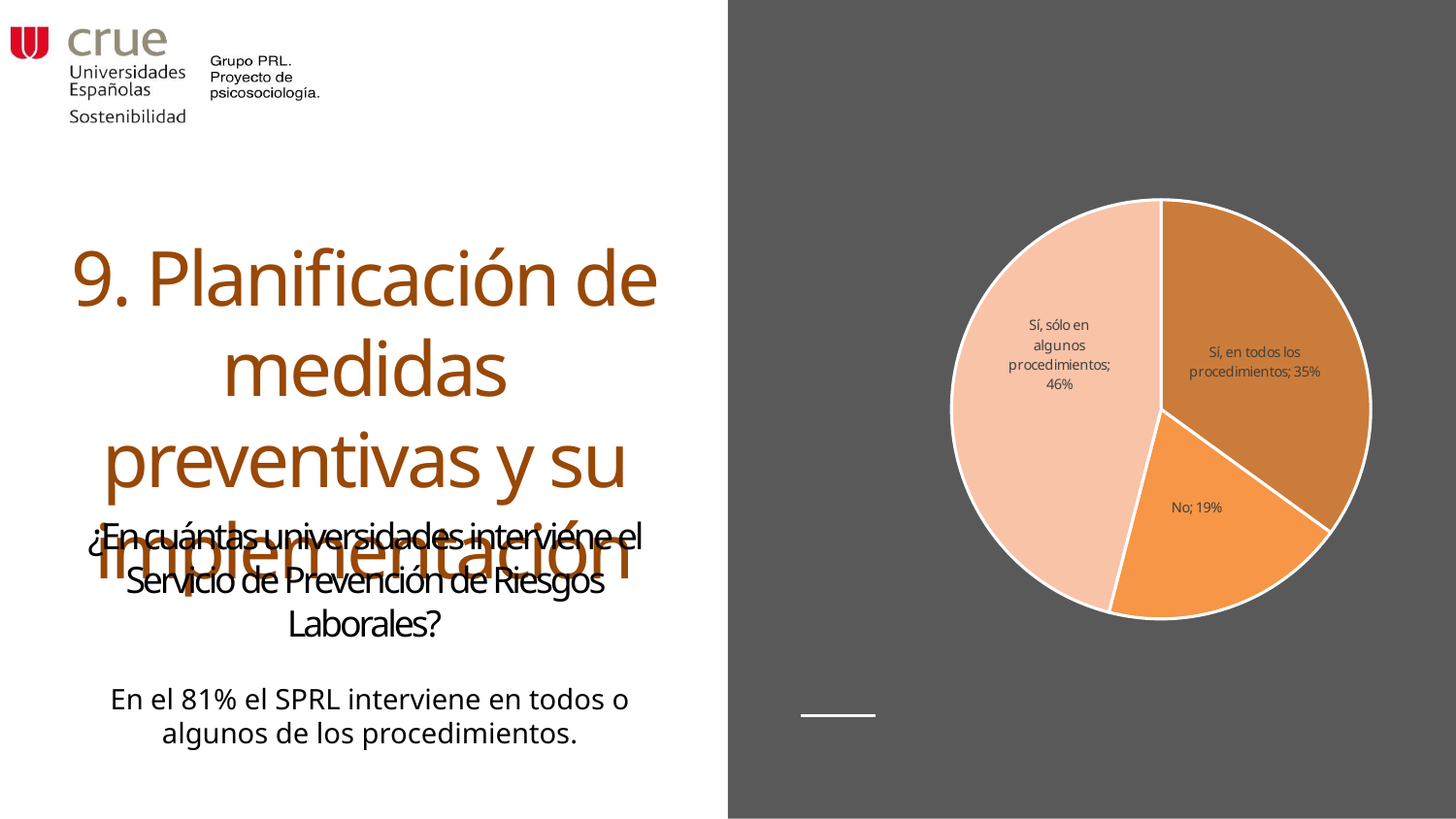
What percentage is shown for the slice 'Sí, en todos los procedimientos'? 35% What is the combined share of the two 'Sí' slices? 81% What colour is the 'No' slice in the pie chart? orange What percentage is shown for the slice 'Sí, sólo en algunos procedimientos'? 46% Which slice of the pie chart is the largest? Sí, sólo en algunos procedimientos How many slices does the pie chart have? 3 Which slice of the pie chart is the smallest? No What is the difference in percentage points between 'Sí, sólo en algunos procedimientos' and 'Sí, en todos los procedimientos'? 11 Which is larger: the 'No' slice or the 'Sí, en todos los procedimientos' slice? Sí, en todos los procedimientos What kind of chart is shown on the slide? pie chart What percentage is shown for the 'No' slice? 19% What is the difference in percentage points between 'Sí, en todos los procedimientos' and 'No'? 16